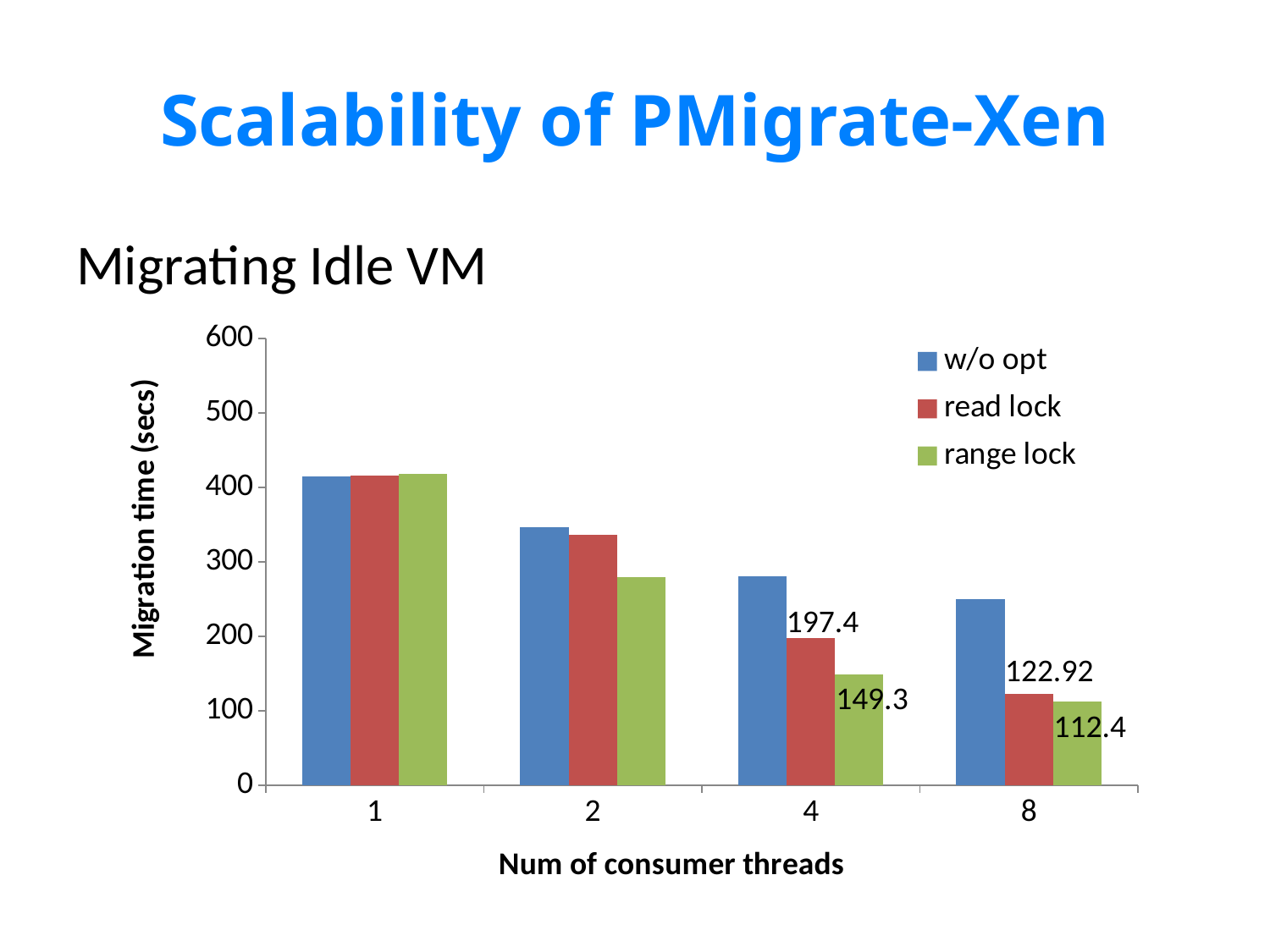
What is the migration time for range lock with 4 consumer threads? 149.3 What is the migration time for range lock with 8 consumer threads? 112.4 What is the migration time for read lock with 8 consumer threads? 122.92 What is the migration time for read lock with 4 consumer threads? 197.4 How many series does the legend list? 3 Is the migration time for w/o opt with 1 consumer thread greater or less than 400? greater With 8 consumer threads, which has the larger migration time: read lock or range lock? read lock With 8 consumer threads, what is the difference between the read lock and range lock migration times? 10.52 Is the migration time for range lock with 2 consumer threads greater or less than 300? less How many consumer thread counts are shown on the x axis? 4 With 4 consumer threads, how much longer is the read lock migration time than the range lock migration time? 48.1 How does the w/o opt migration time change as the number of consumer threads increases? It falls